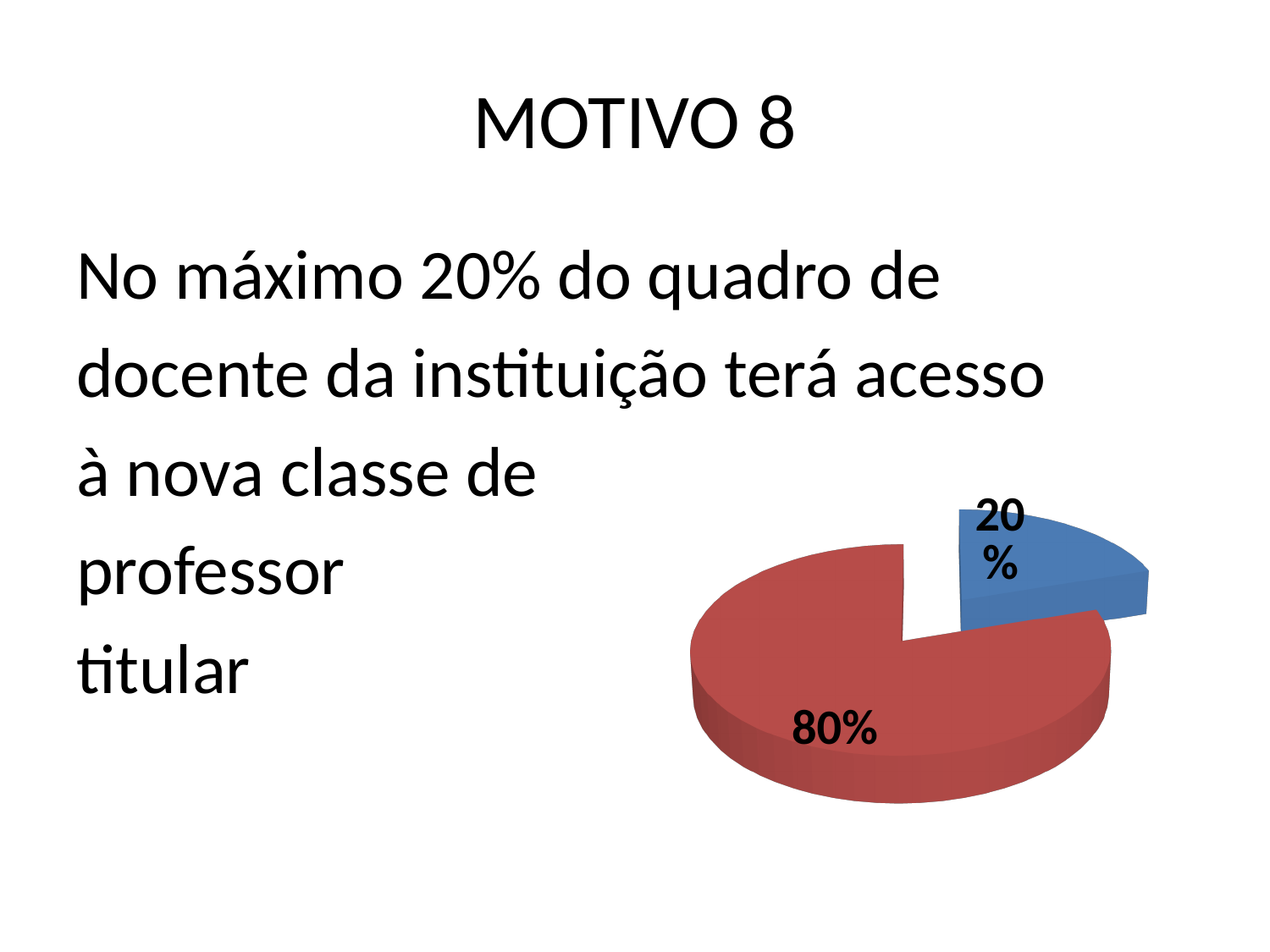
What is the difference between the red slice and the blue slice of the pie chart? 60% What kind of chart is shown on the slide? pie chart What colour is the slice labelled 80%? red Which slice of the pie chart is the smallest? the blue slice (20%) How many slices does the pie chart have? 2 What share of the pie does the blue slice represent? 20% Which slice of the pie chart is the largest? the red slice (80%) What value is shown on the red slice of the pie chart? 80% What value is shown on the blue slice of the pie chart? 20% Which slice of the pie chart is pulled out from the rest? the blue slice (20%) Which slice is larger, the red one or the blue one? the red one